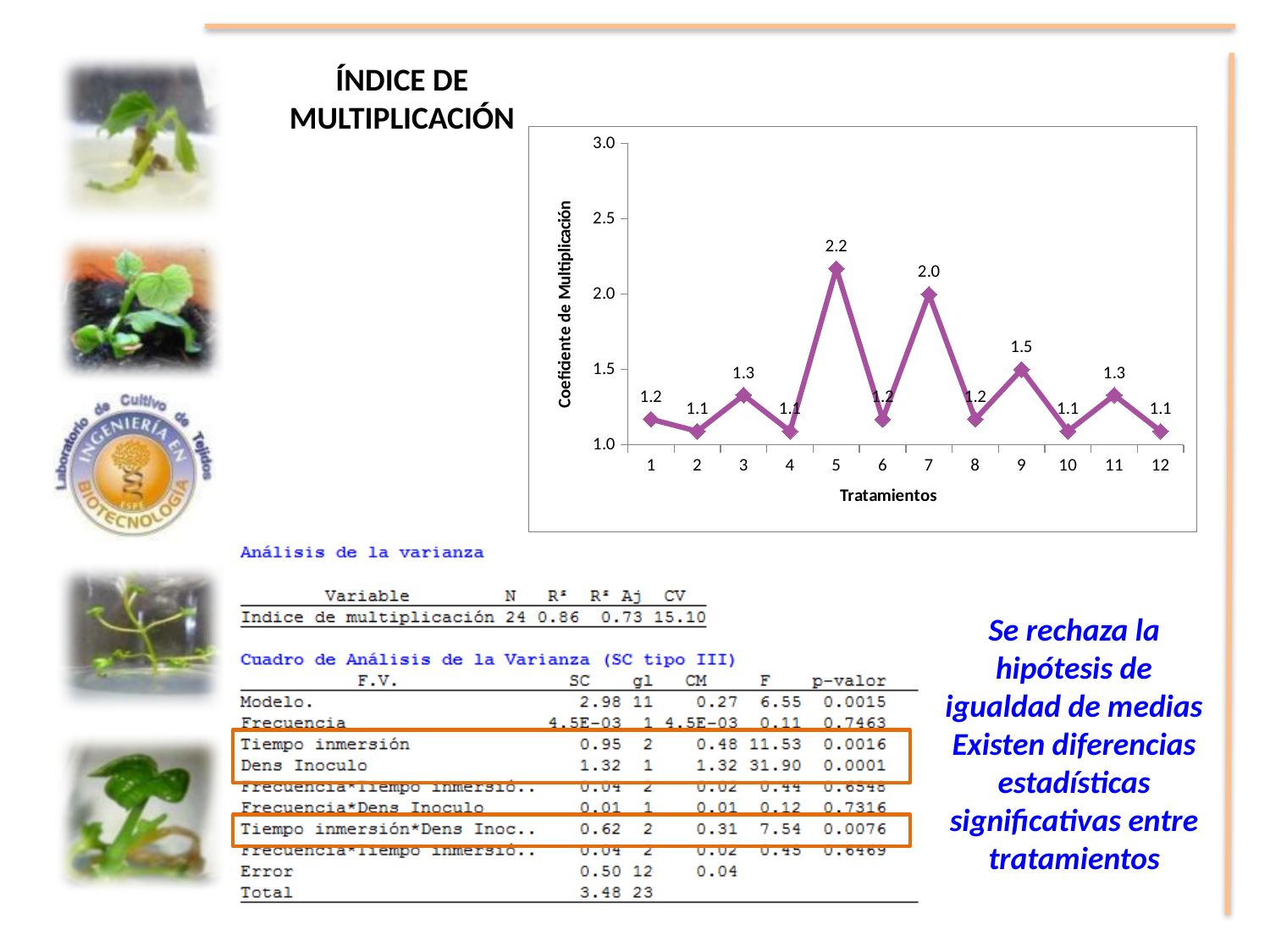
What is the Coeficiente de Multiplicación for Tratamiento 9? 1.5 Which has a larger Coeficiente de Multiplicación, Tratamiento 7 or Tratamiento 9? Tratamiento 7 What is the label of the y axis of the chart? Coeficiente de Multiplicación What type of chart is shown on the slide? Line chart What is the label of the x axis of the chart? Tratamientos How many Tratamientos are plotted on the x axis of the chart? 12 Is the value for Tratamiento 5 greater or less than 2.0? greater Which Tratamiento has the highest Coeficiente de Multiplicación? 5 What is the Coeficiente de Multiplicación for Tratamiento 5? 2.2 What is the Coeficiente de Multiplicación for Tratamiento 7? 2.0 What is the difference between the Coeficiente de Multiplicación for Tratamiento 5 and Tratamiento 7? 0.2 What is the difference between the Coeficiente de Multiplicación for Tratamiento 9 and Tratamiento 1? 0.3